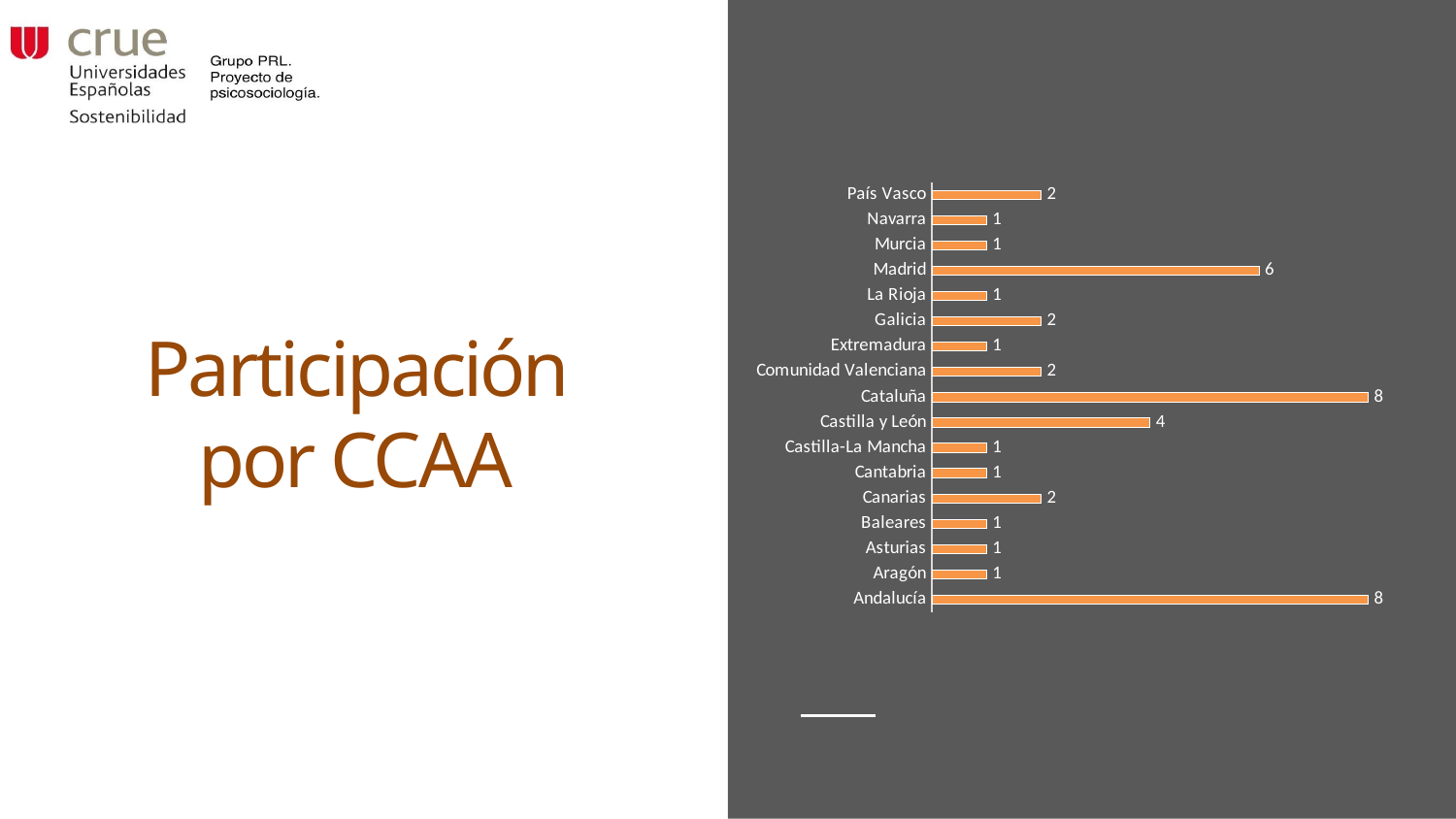
How many categories (CCAA) are shown in the chart? 17 What is the value for Galicia? 2 What is the difference between the values for Cataluña and Madrid? 2 What is the value for Madrid? 6 What is the value for Castilla y León? 4 Which has a larger value, Castilla y León or Canarias? Castilla y León What is the value for Extremadura? 1 What is the highest value shown in the chart? 8 What is the difference between the values for Madrid and Castilla y León? 2 What is the value for Andalucía? 8 What is the title of the slide containing the chart? Participación por CCAA What kind of chart is shown on the slide? bar chart